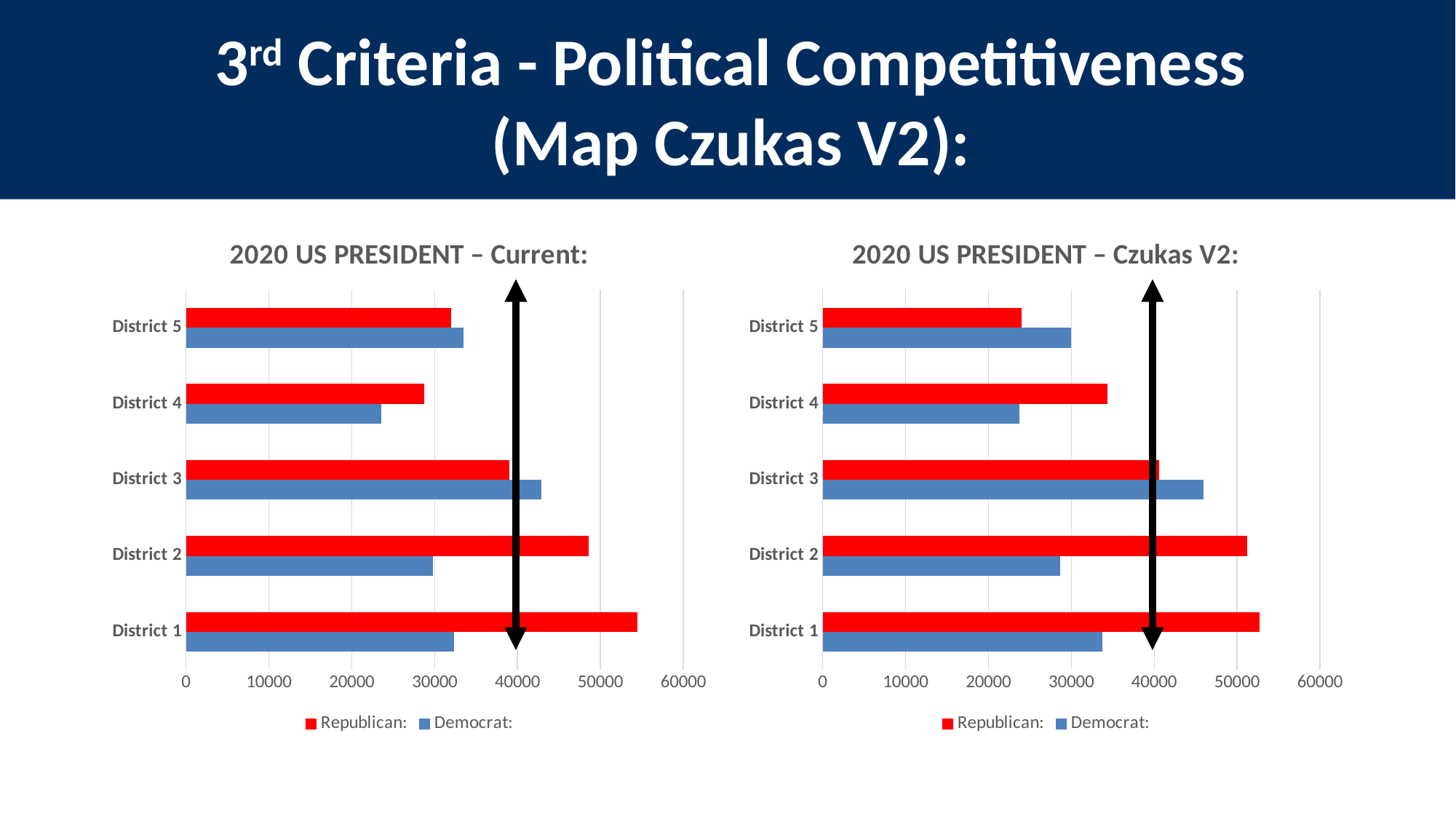
In the "2020 US PRESIDENT – Czukas V2:" chart, is the Republican value for District 5 greater or less than 30000? less What kind of chart is the "2020 US PRESIDENT – Current:" chart? Bar chart In the "2020 US PRESIDENT – Current:" chart, which district has the lowest Republican value? District 4 In the "2020 US PRESIDENT – Current:" chart, which is larger for District 2, the Republican or the Democrat value? Republican In the "2020 US PRESIDENT – Czukas V2:" chart, which district has the highest Democrat value? District 3 What colour represents the Democrat series in the charts? Blue How many districts are shown on the "2020 US PRESIDENT – Current:" chart? 5 In the "2020 US PRESIDENT – Czukas V2:" chart, which is larger for District 4, the Republican or the Democrat value? Republican How many series does the legend of the "2020 US PRESIDENT – Czukas V2:" chart list? 2 In the "2020 US PRESIDENT – Czukas V2:" chart, which district has the lowest Republican value? District 5 In the "2020 US PRESIDENT – Current:" chart, which district has the highest Republican value? District 1 In the "2020 US PRESIDENT – Current:" chart, is the Democrat value for District 3 greater or less than 40000? greater